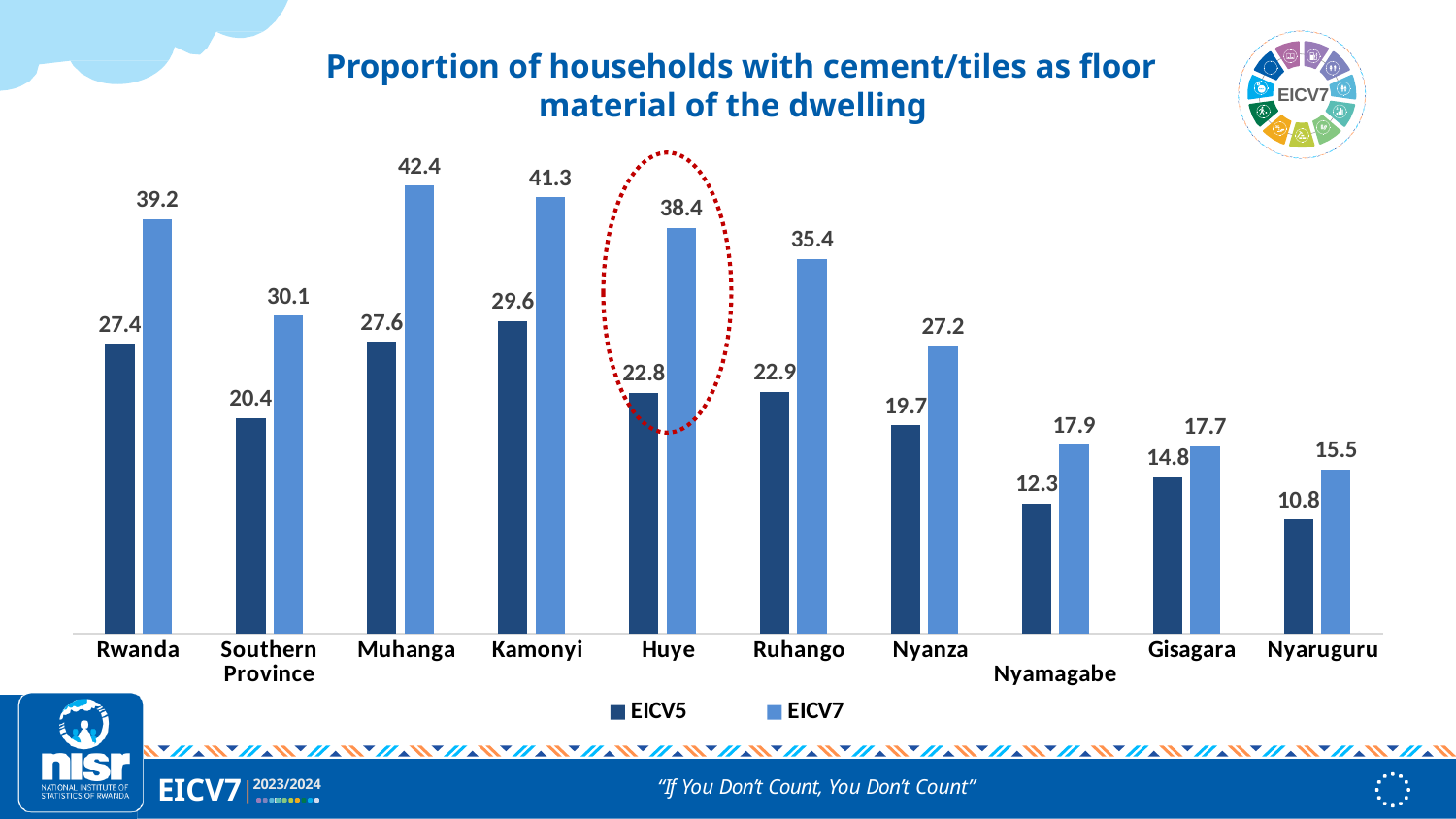
What kind of chart is shown on the slide? Bar chart Which district has the highest EICV7 value? Muhanga Which category is highlighted with a red dotted circle? Huye What is the EICV7 value for Huye? 38.4 What is the EICV7 value for Rwanda? 39.2 What is the EICV5 value for Southern Province? 20.4 Which category has the highest EICV5 value? Kamonyi How many categories are shown on the x axis? 10 Which category has the lowest EICV5 value? Nyaruguru What is the difference between the EICV7 and EICV5 values for Huye? 15.6 Which is larger, the EICV7 value for Kamonyi or the EICV7 value for Ruhango? Kamonyi How many series does the legend list? 2